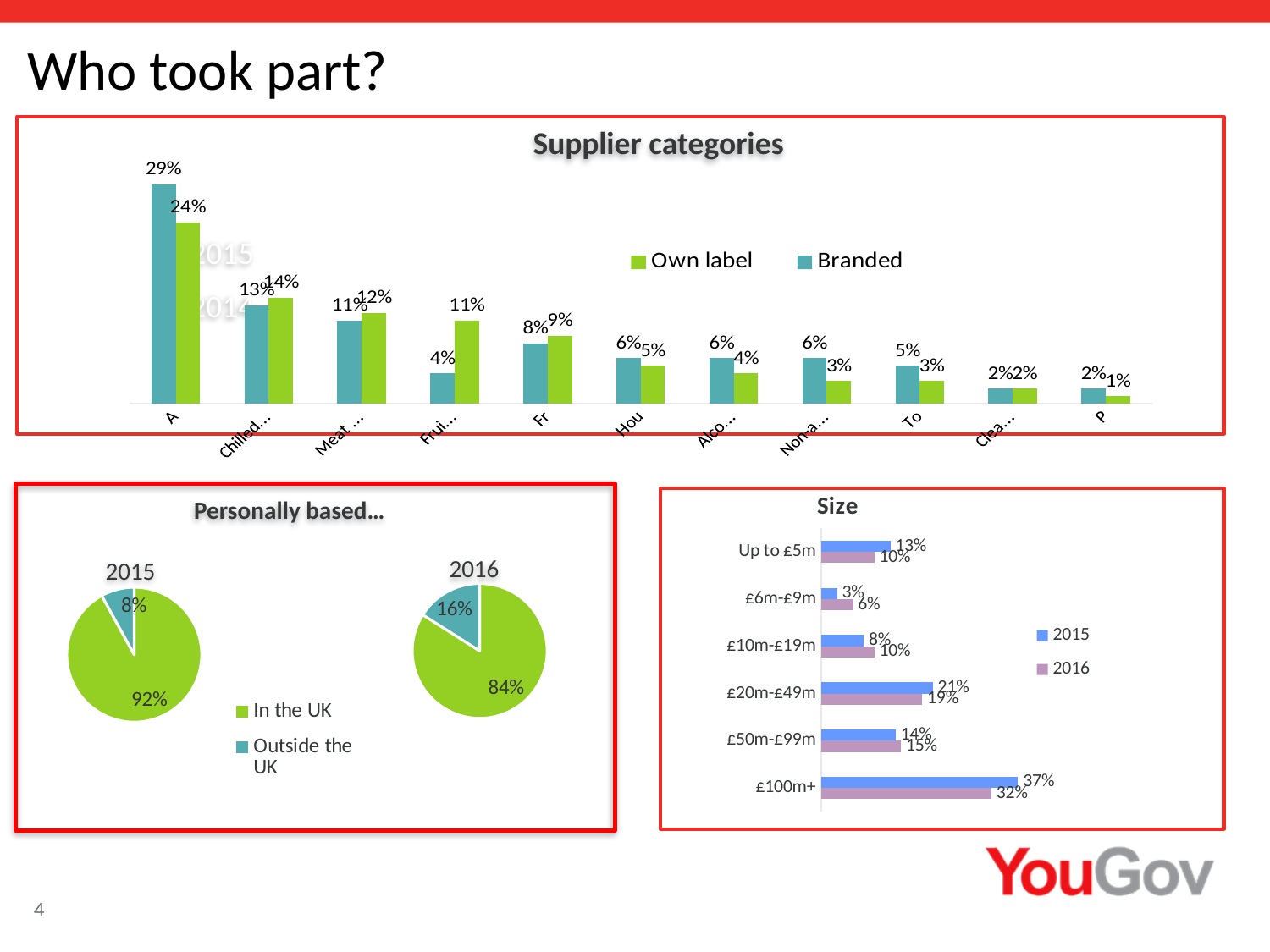
In the Size chart, which size band has the lowest 2015 value? £6m-£9m In the Size chart, what is the 2016 value for £6m-£9m? 6% In the Size chart, is the 2015 or the 2016 value larger for £20m-£49m? 2015 In the Size chart, what is the 2015 value for £100m+? 37% In the Size chart, which size band has the highest 2015 value? £100m+ In the Supplier categories chart, how many series does the legend list? 2 In the Personally based... chart, what is the difference between the In the UK share in 2015 and in 2016? 8% In the Size chart, how many size bands are shown? 6 In the Size chart, what is the difference between the 2015 and 2016 values for £100m+? 5% What kind of chart is the Supplier categories chart? Bar chart In the Personally based... chart, what share of the 2016 pie is Outside the UK? 16% In the Personally based... chart, what share of the 2015 pie is In the UK? 92%